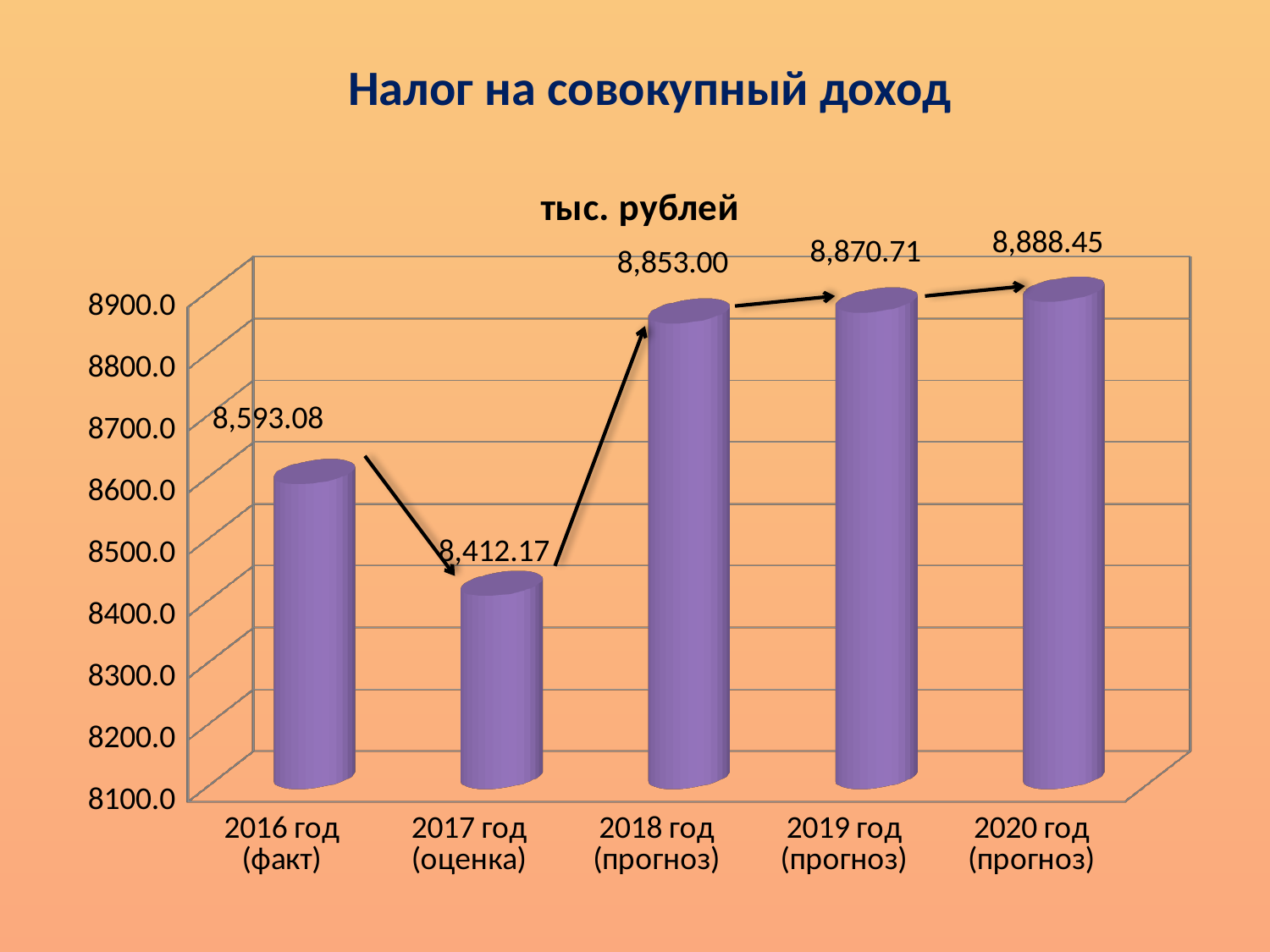
What is the difference between the values for 2016 год (факт) and 2017 год (оценка)? 180.91 What is the difference between the values for 2018 год (прогноз) and 2017 год (оценка)? 440.83 Which year has the highest value? 2020 год (прогноз) How many categories are shown on the x axis? 5 What is the value for 2016 год (факт)? 8,593.08 What is the value for 2018 год (прогноз)? 8,853.00 What kind of chart is shown on the slide? Bar chart What is the value for 2020 год (прогноз)? 8,888.45 What is the value for 2017 год (оценка)? 8,412.17 Which year has the lowest value? 2017 год (оценка) What is the title of the slide? Налог на совокупный доход Which is larger, the value for 2016 год (факт) or the value for 2017 год (оценка)? 2016 год (факт)